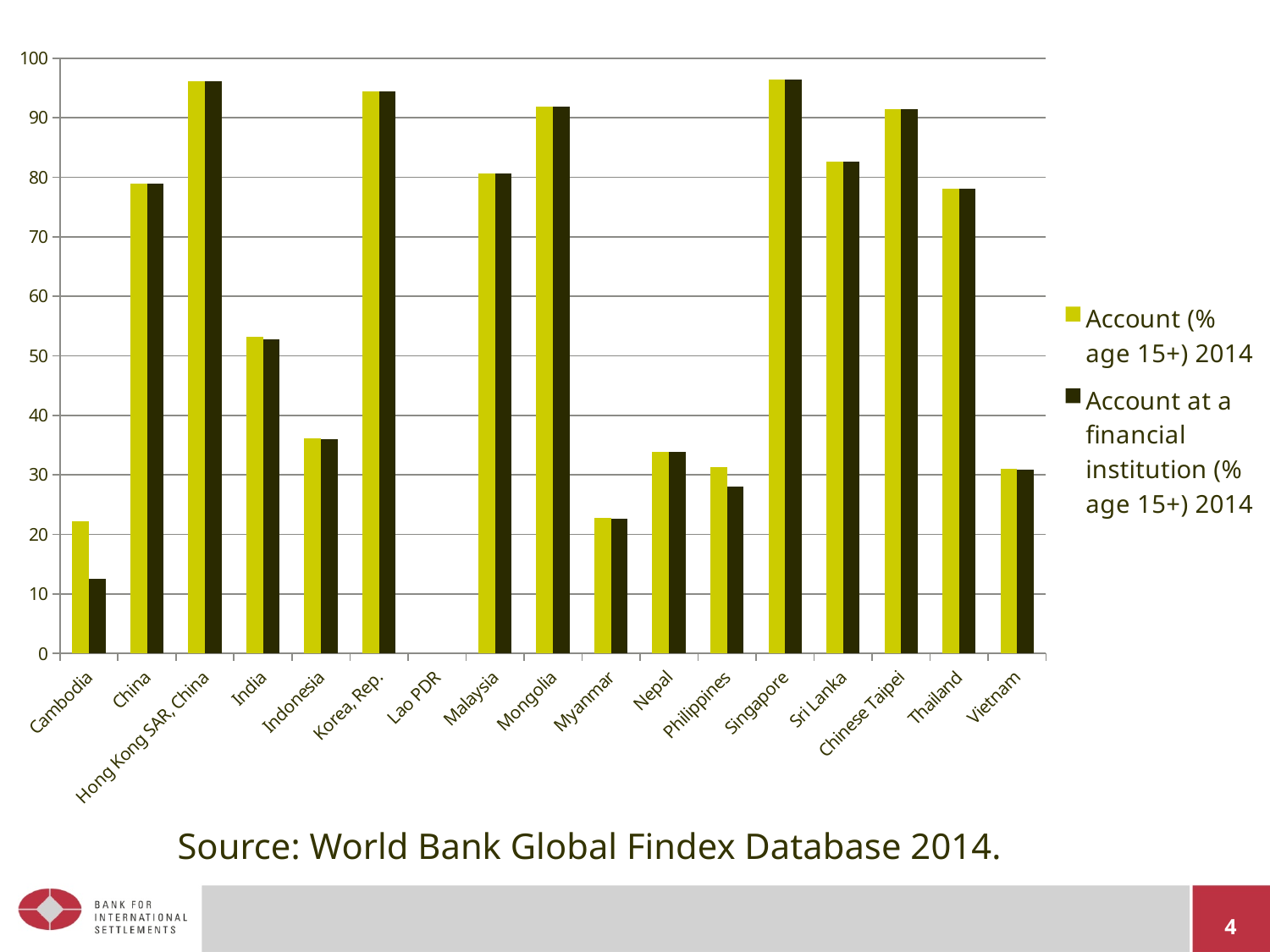
Is the value for Korea, Rep. in the Account (% age 15+) 2014 series greater or less than 90? greater Among the countries with bars shown, which has the lowest value for Account at a financial institution (% age 15+) 2014? Cambodia Is the value for Philippines in the Account at a financial institution (% age 15+) 2014 series greater or less than 30? less Is the value for Cambodia in the Account at a financial institution (% age 15+) 2014 series greater or less than 20? less For Cambodia, which is larger: Account (% age 15+) 2014 or Account at a financial institution (% age 15+) 2014? Account (% age 15+) 2014 What kind of chart is shown on the slide? Bar chart Which country on the x axis has no bars plotted? Lao PDR How many countries or economies are listed on the x axis? 17 How many series does the legend list? 2 In the Account (% age 15+) 2014 series, which is larger: India or Indonesia? India